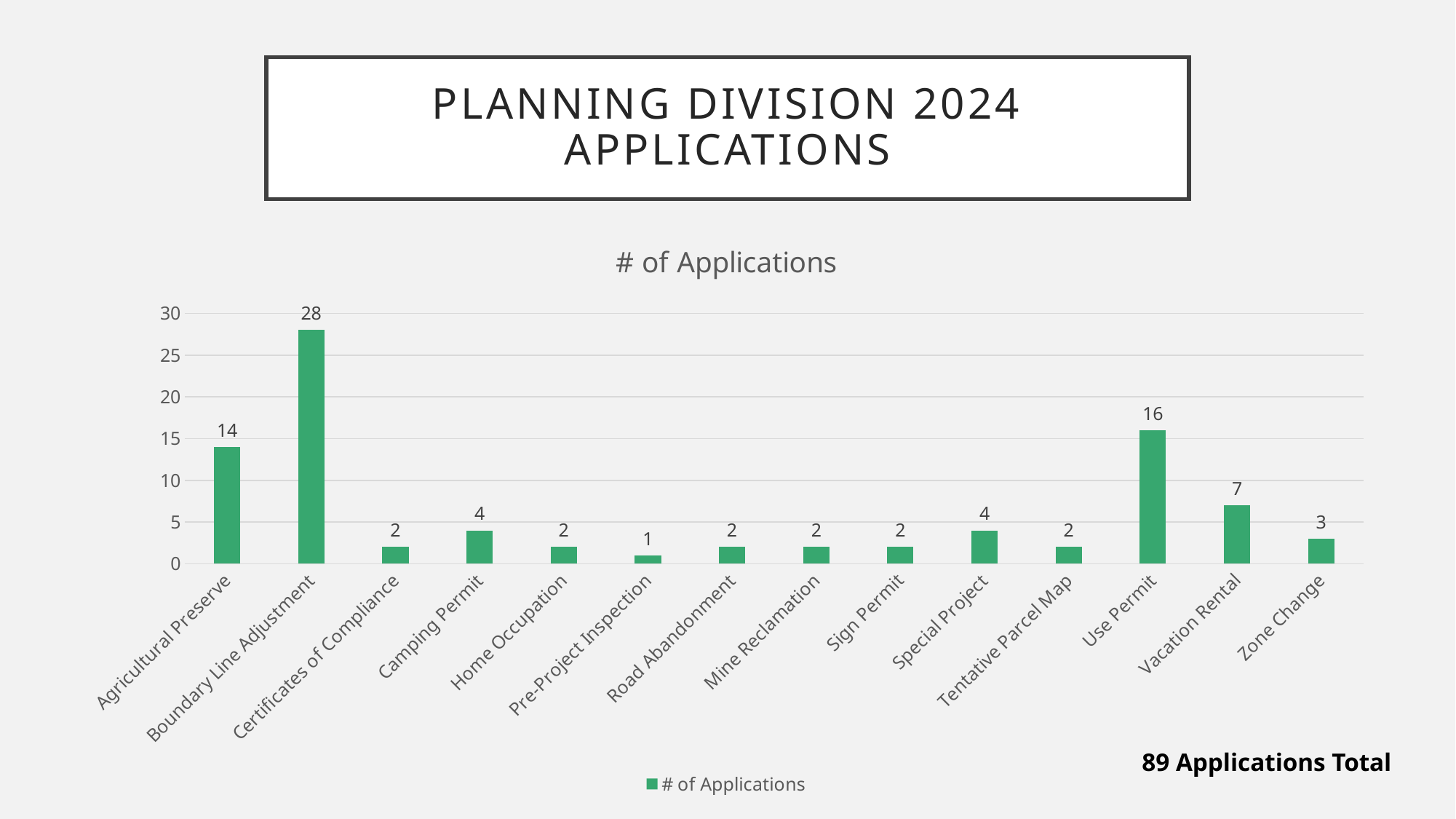
What kind of chart is shown? Bar chart How many applications were there for Boundary Line Adjustment? 28 How many applications were there for Vacation Rental? 7 How many series does the legend list? 1 Which category has the lowest number of applications? Pre-Project Inspection What is the title of the chart? # of Applications What is the difference between Agricultural Preserve and Vacation Rental? 7 Which is larger, Camping Permit or Zone Change? Camping Permit Which category has the highest number of applications? Boundary Line Adjustment What is the difference between Boundary Line Adjustment and Use Permit? 12 How many categories are shown on the x axis? 14 What is the value for Use Permit? 16